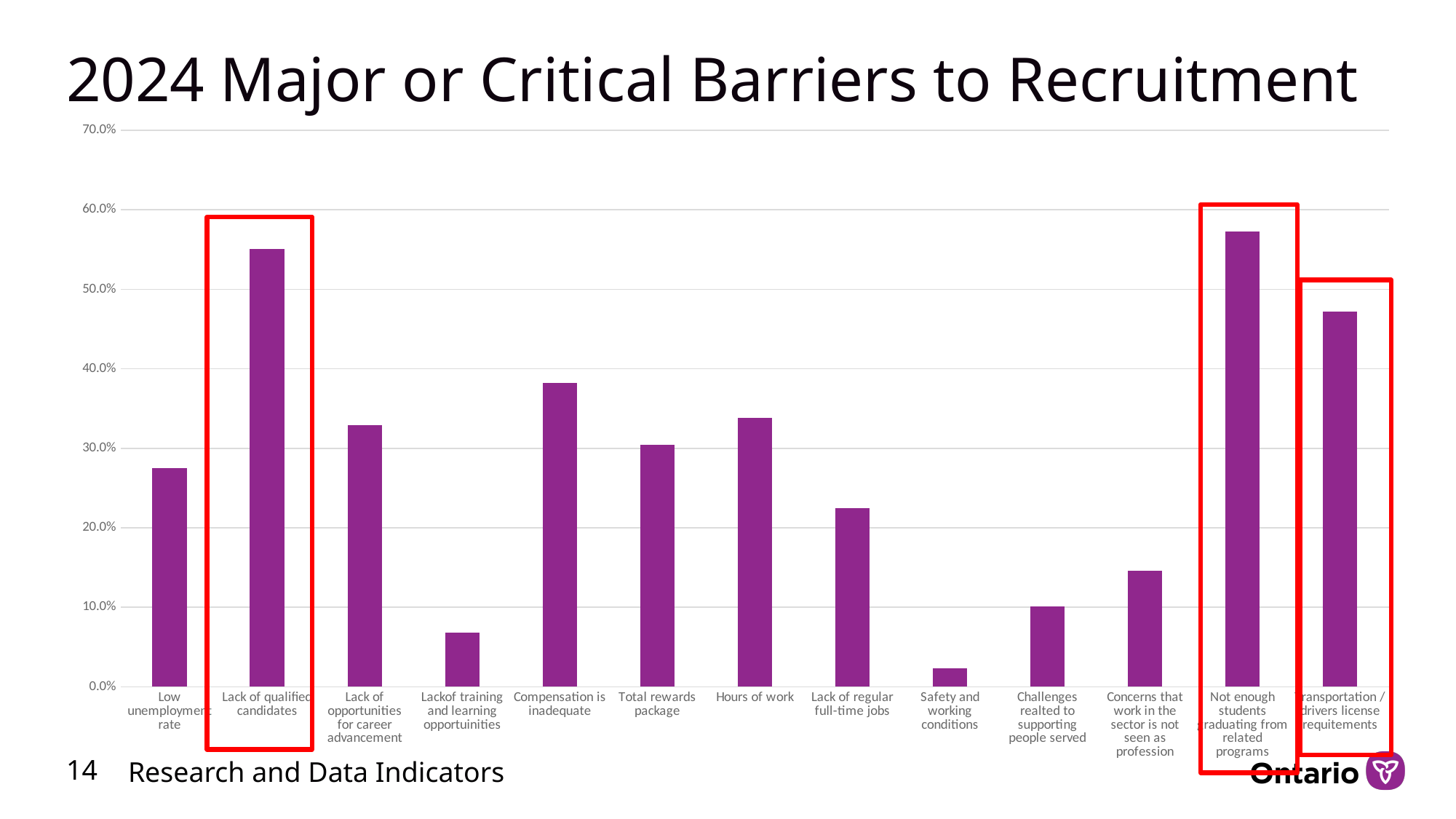
Which is larger: the value for Lack of qualified candidates or the value for Transportation / drivers license requitements? Lack of qualified candidates What is the title of the chart? 2024 Major or Critical Barriers to Recruitment Which is larger: the value for Compensation is inadequate or the value for Hours of work? Compensation is inadequate Is the value for Transportation / drivers license requitements greater or less than 40.0%? greater Is the value for Low unemployment rate greater or less than 30.0%? less What kind of chart is shown on the slide? Bar chart How many barriers (categories) are plotted on the chart? 13 Is the value for Compensation is inadequate greater or less than 30.0%? greater Which barrier has the highest value on the chart? Not enough students graduating from related programs Which barrier has the lowest value on the chart? Safety and working conditions How many bars are highlighted with red boxes on the chart? 3